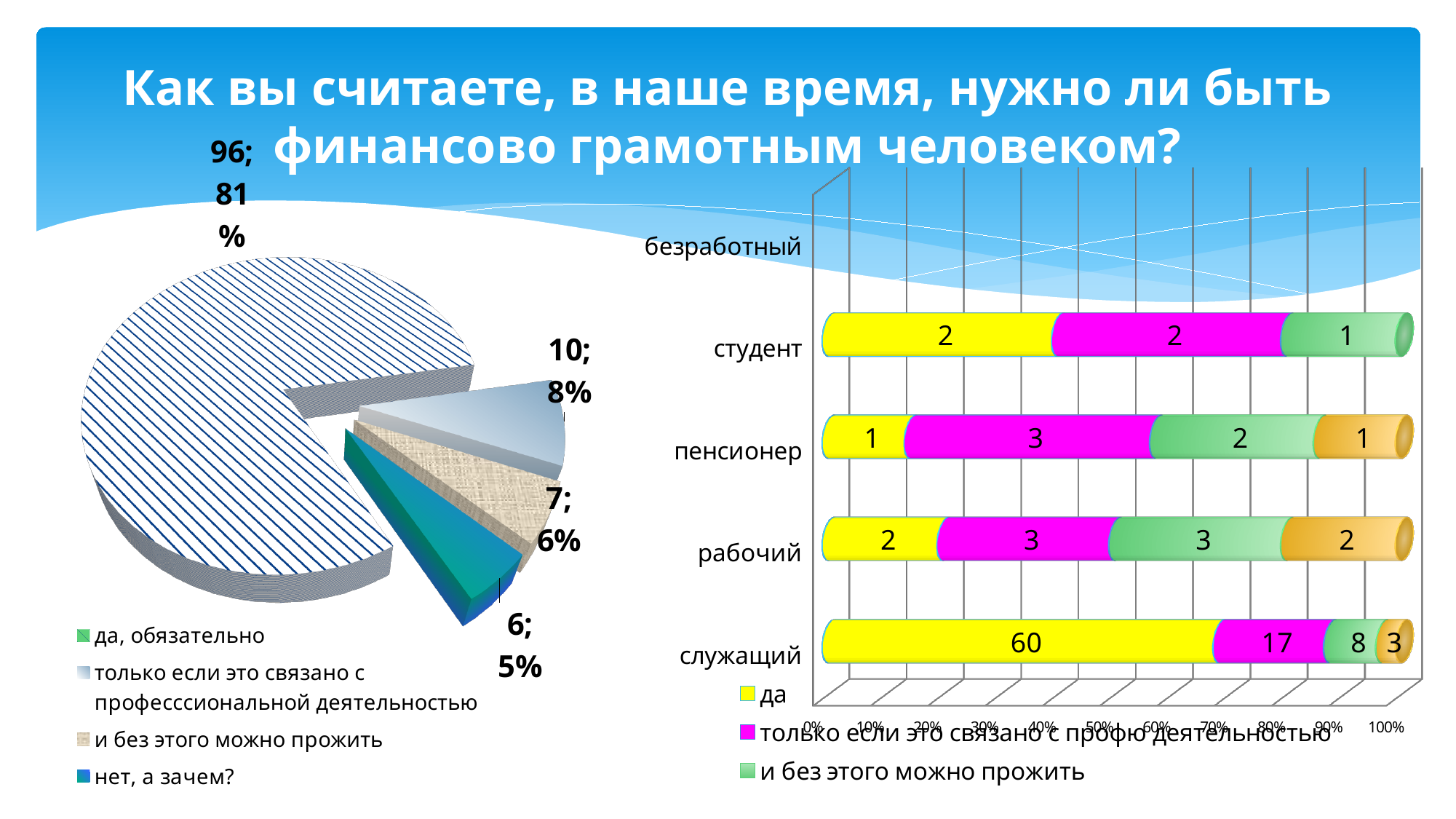
On the pie chart on the left, which legend entry is listed first? да, обязательно On the bar chart on the right, which category has the largest 'да' value? служащий What kind of chart is shown on the right side of the slide? stacked bar chart On the bar chart on the right, what is the value of the magenta segment for пенсионер? 3 On the bar chart on the right, what is the total of the labelled segments for служащий? 88 On the pie chart on the left, what percentage is shown for the largest slice? 81% On the pie chart on the left, what is the difference between the count of the largest slice (96) and the slice labelled 10? 86 On the pie chart on the left, how many slices are there? 4 On the bar chart on the right, what is the value of the 'да' segment for служащий? 60 On the bar chart on the right, what is the total of the labelled segments for рабочий? 10 On the bar chart on the right, how many series does the legend list? 3 On the pie chart on the left, what count and percentage are shown for the smallest slice? 6; 5%